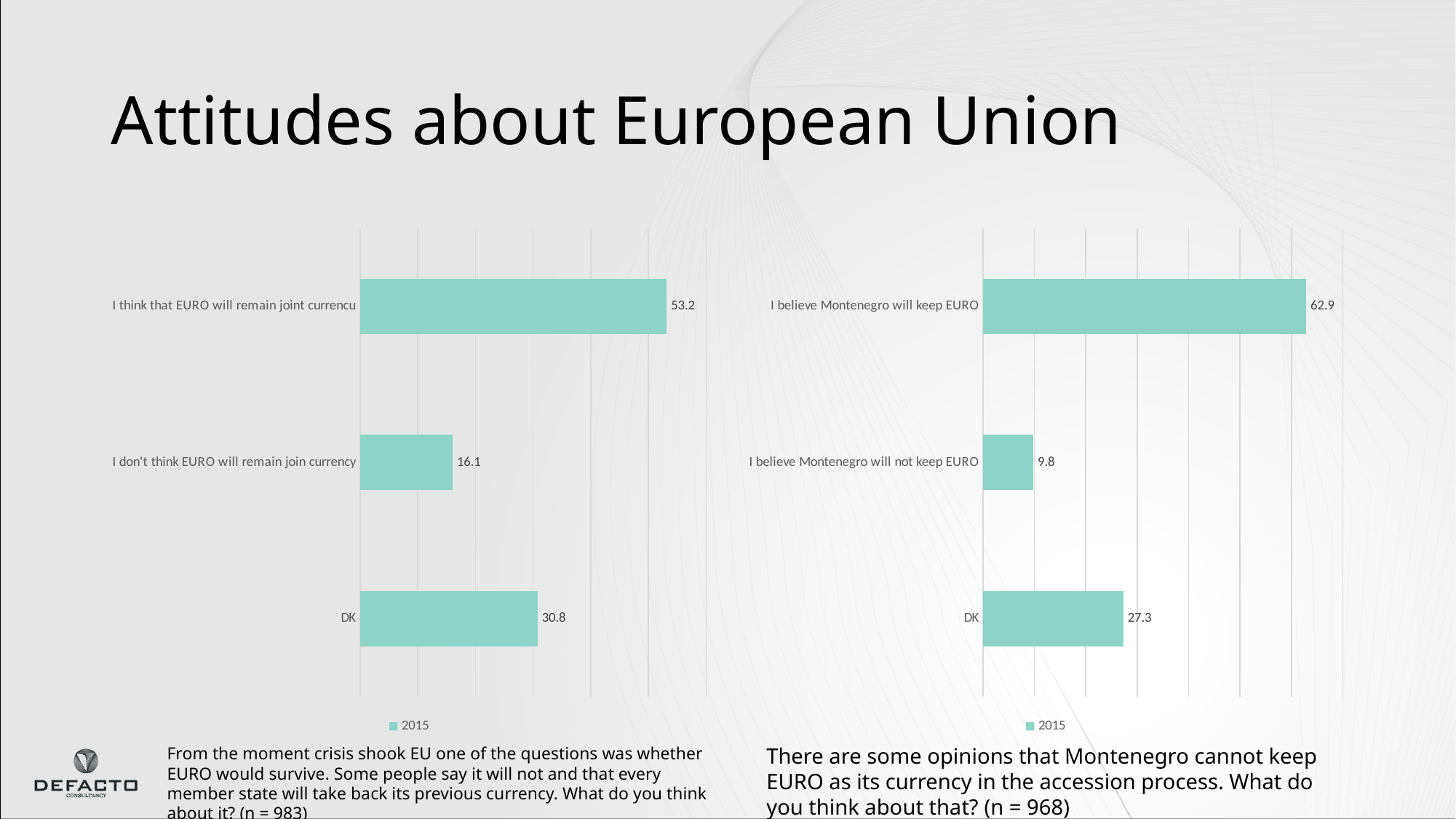
In the left chart, what is the value for "DK"? 30.8 How many categories does the left chart show? 3 How many series does the legend of the right chart list? 1 In the left chart, what is the difference between the values for "I think that EURO will remain joint currencu" and "DK"? 22.4 In the right chart, what is the value for "I believe Montenegro will not keep EURO"? 9.8 What kind of chart is the left chart? Bar chart In the right chart, what is the value for "I believe Montenegro will keep EURO"? 62.9 In the right chart, what is the difference between the values for "DK" and "I believe Montenegro will not keep EURO"? 17.5 In the right chart, which category has the highest value? I believe Montenegro will keep EURO In the left chart, what is the value for "I think that EURO will remain joint currencu"? 53.2 In the left chart, which category has the lowest value? I don't think EURO will remain join currency In the right chart, which is larger: the value for "DK" or the value for "I believe Montenegro will not keep EURO"? DK